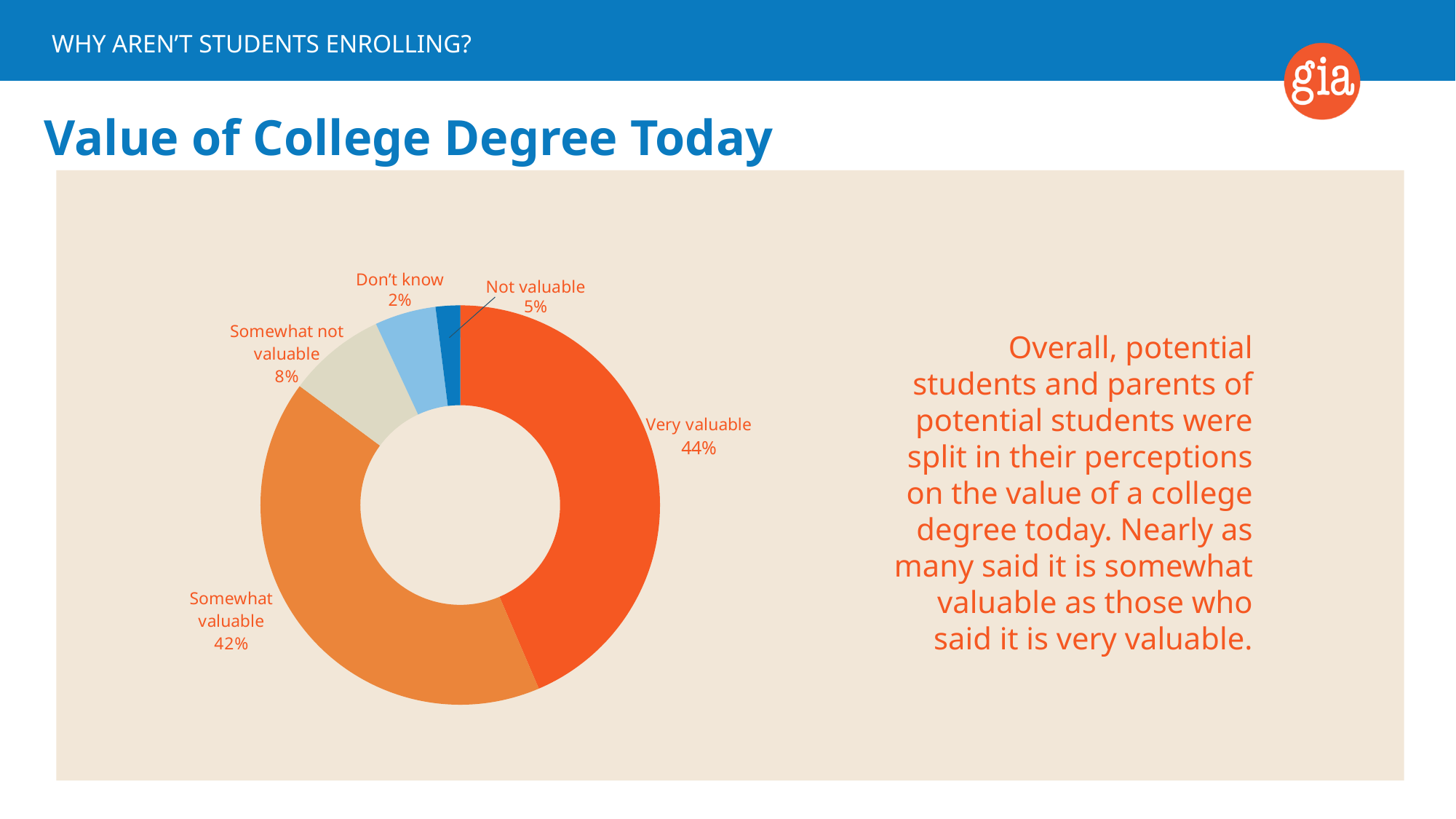
How many categories are shown in the chart? 5 Which category has the smallest share of the chart? Don't know Which category has the largest share of the chart? Very valuable What is the difference in percentage points between 'Very valuable' and 'Somewhat valuable'? 2 percentage points What share of respondents said a college degree is somewhat valuable? 42% What share of respondents said a college degree is very valuable? 44% Which is larger, the share for 'Somewhat not valuable' or the share for 'Not valuable'? Somewhat not valuable What share of respondents said a college degree is somewhat not valuable? 8% What share of respondents answered 'Don't know'? 2% What is the title of the slide containing the chart? Value of College Degree Today What share of respondents said a college degree is not valuable? 5% What kind of chart is shown on the slide? Doughnut (pie) chart